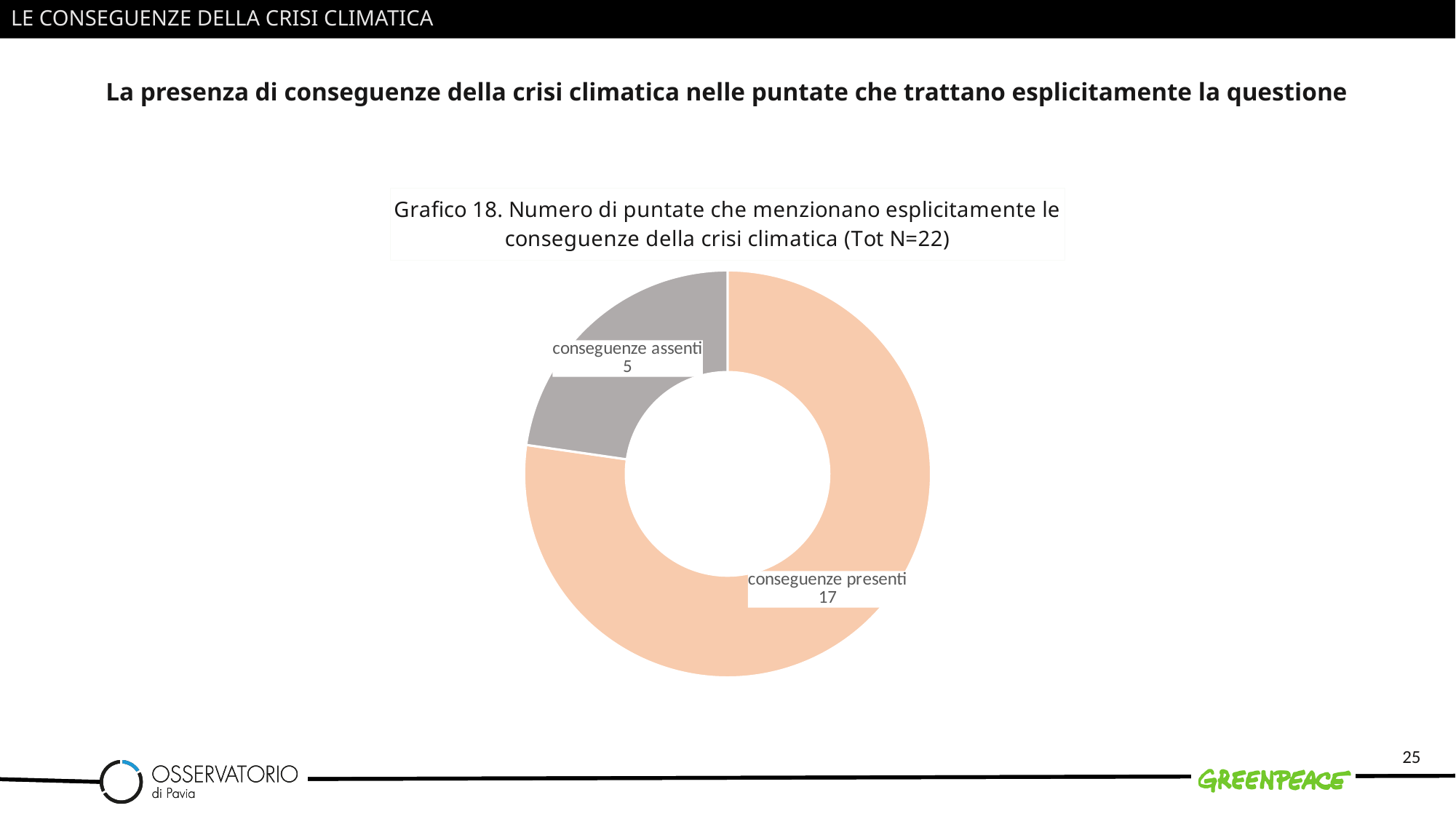
Which category has the lowest value? conseguenze assenti Which category has the highest value? conseguenze presenti What kind of chart is shown on the slide? Doughnut chart What is the chart number given in the chart title? Grafico 18 What is the value for "conseguenze presenti"? 17 Which is larger, "conseguenze presenti" or "conseguenze assenti"? conseguenze presenti What is the total N stated in the chart title? 22 How many categories does the chart show? 2 What is the difference between the values for "conseguenze presenti" and "conseguenze assenti"? 12 What is the total of the two values shown in the chart? 22 What is the value for "conseguenze assenti"? 5